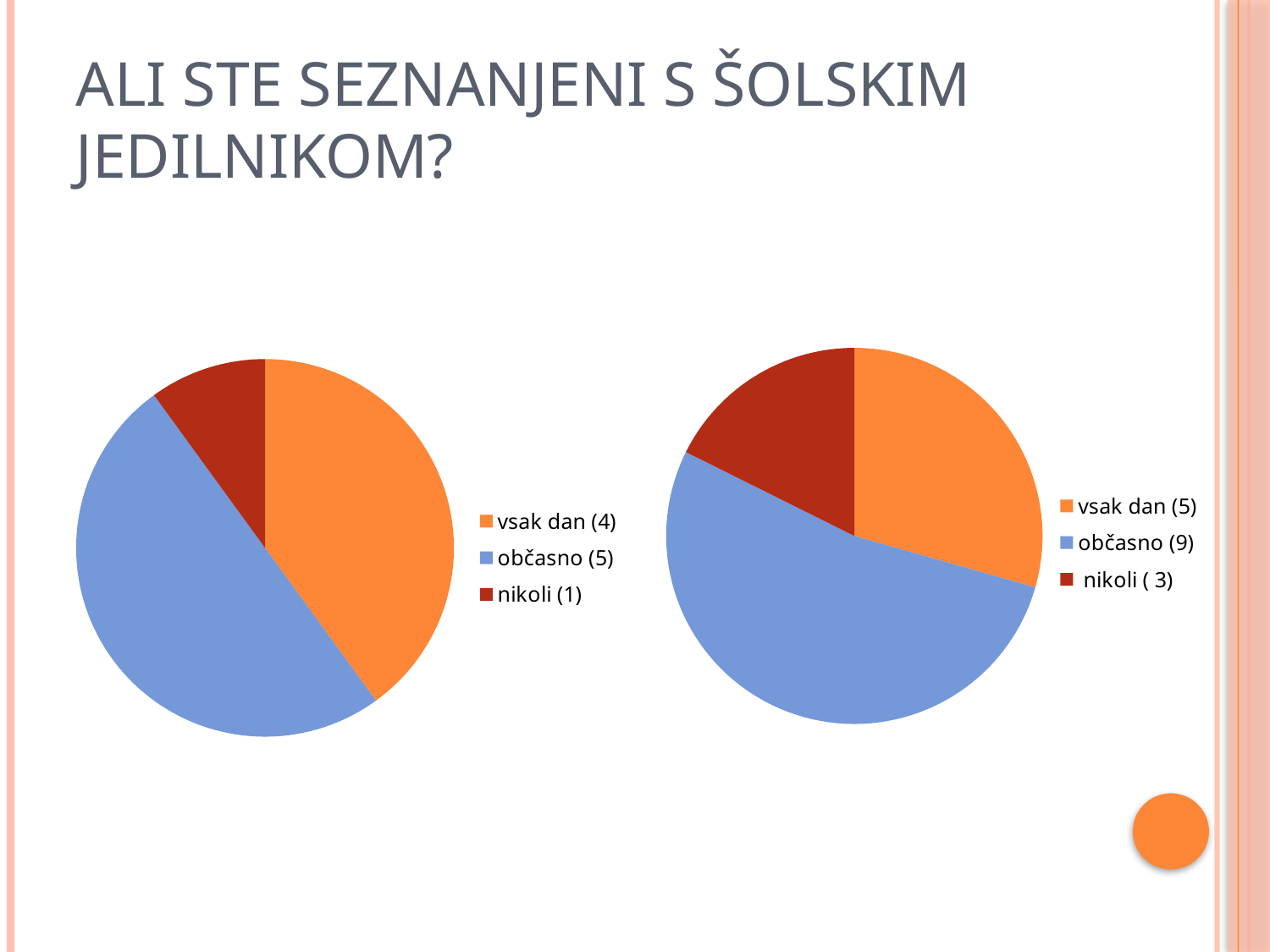
In the left pie chart, which is larger, vsak dan or občasno? občasno What kind of chart is shown on the left of the slide? pie chart In the right pie chart, which category has the largest slice? občasno In the right pie chart, what colour is the slice for nikoli? dark red In the right pie chart, what is the difference between the values for občasno and nikoli? 6 How many categories does the legend of the right pie chart list? 3 In the left pie chart, what share of the total does vsak dan represent? 40% In the left pie chart, which category has the smallest slice? nikoli In the right pie chart, what is the value for vsak dan? 5 In the right pie chart, what is the value for občasno? 9 In the left pie chart, what is the value for nikoli? 1 In the left pie chart, what is the value for občasno? 5